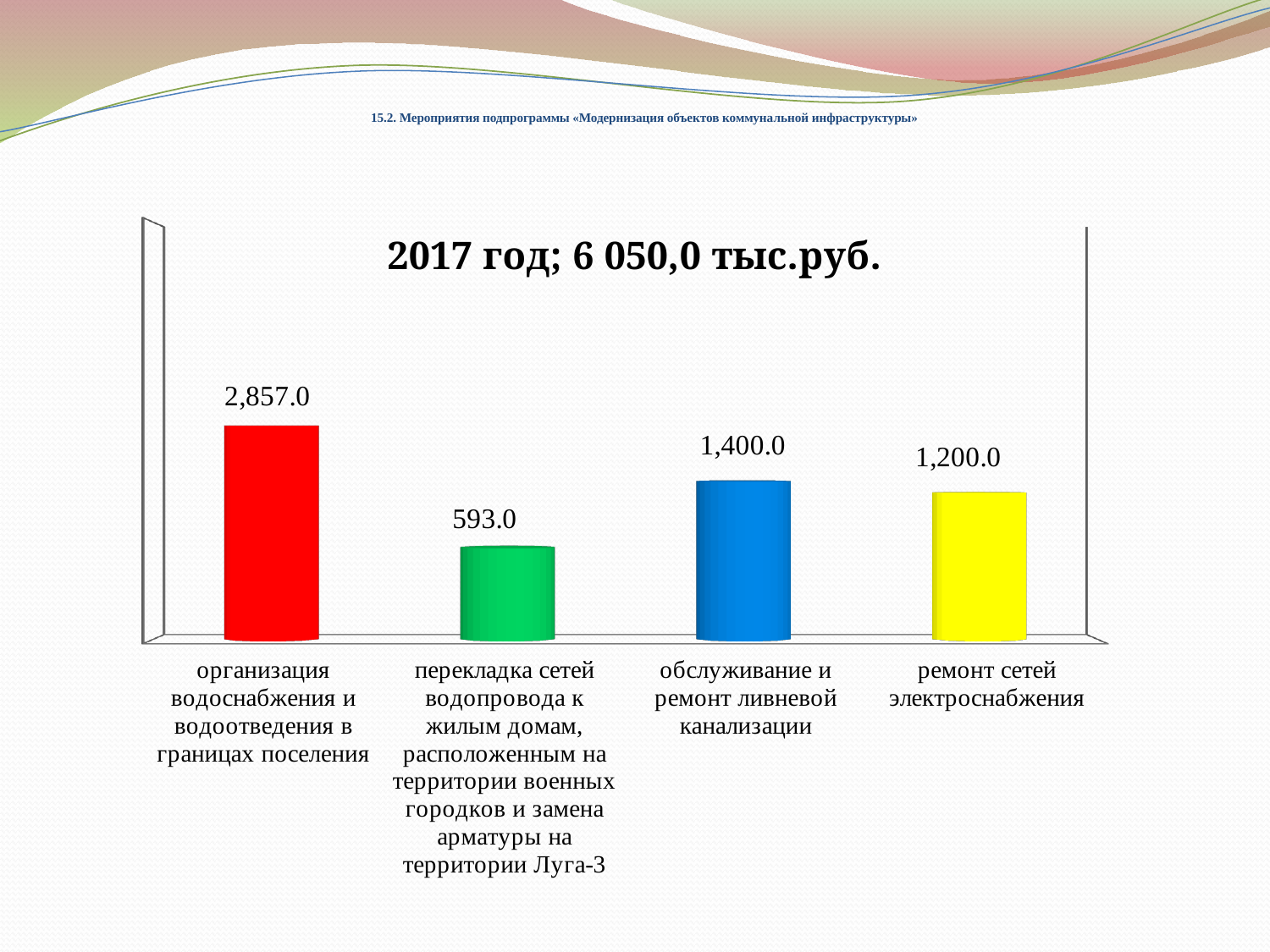
What is the value for «организация водоснабжения и водоотведения в границах поселения»? 2,857.0 Which category has the lowest value? перекладка сетей водопровода к жилым домам, расположенным на территории военных городков и замена арматуры на территории Луга-3 What is the title of the chart? 2017 год; 6 050,0 тыс.руб. What is the value for «ремонт сетей электроснабжения»? 1,200.0 What is the difference between the values for «обслуживание и ремонт ливневой канализации» and «ремонт сетей электроснабжения»? 200.0 How many categories are shown in the chart? 4 Which category has the highest value? организация водоснабжения и водоотведения в границах поселения Which is larger: the value for «обслуживание и ремонт ливневой канализации» or for «ремонт сетей электроснабжения»? обслуживание и ремонт ливневой канализации What kind of chart is shown on the slide? bar chart What is the value for «обслуживание и ремонт ливневой канализации»? 1,400.0 What is the difference between the highest value and the value for «перекладка сетей водопровода...» (593.0)? 2,264.0 What colour is the bar for «ремонт сетей электроснабжения»? yellow